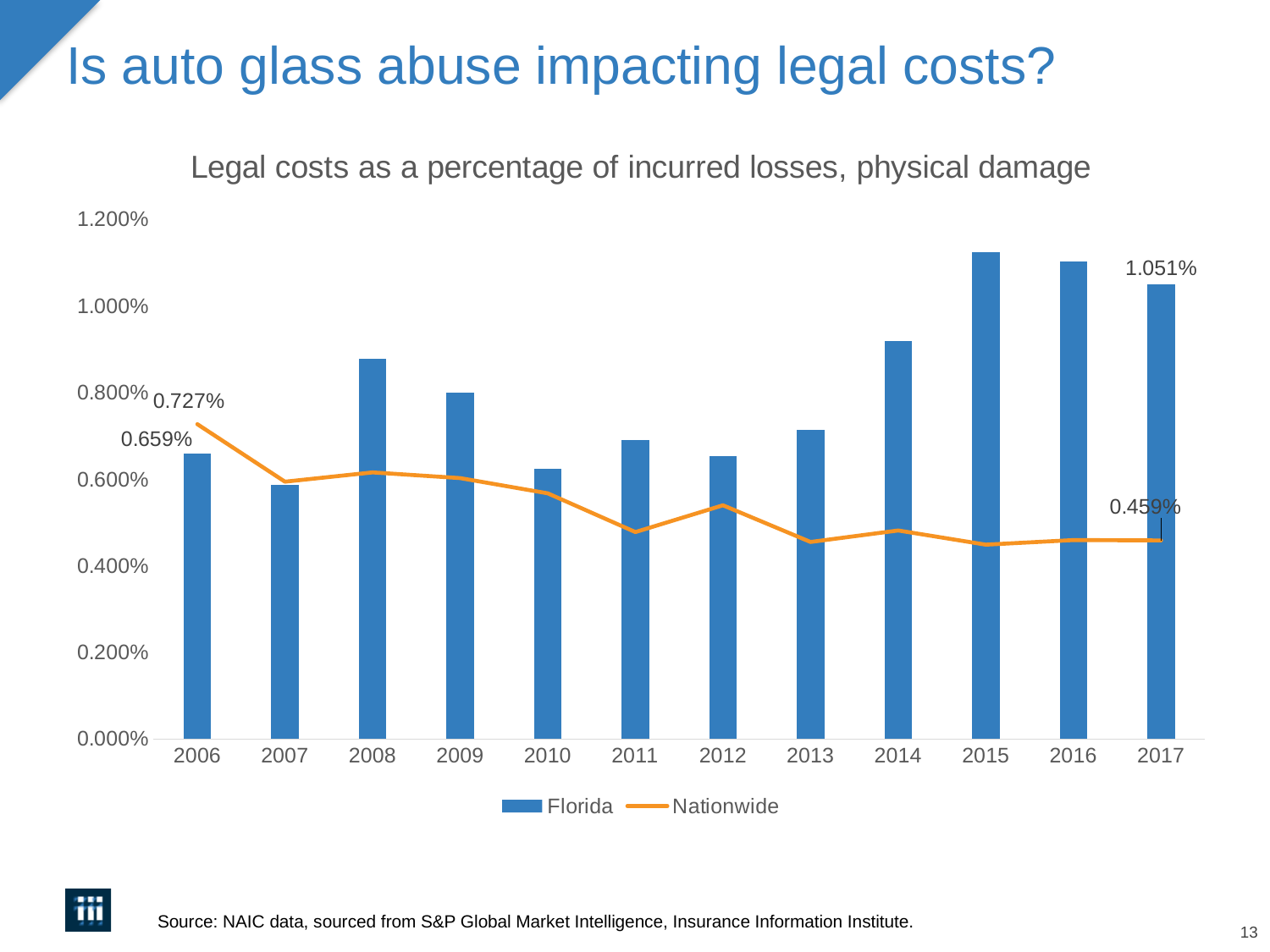
By how much did the Nationwide value decrease from 2006 to 2017? 0.268% What is the Florida value for 2006? 0.659% How many years are shown on the x axis? 12 What is the Nationwide value for 2006? 0.727% Is the Florida value for 2014 greater or less than 1.000%? less In 2006, which is larger: the Florida value or the Nationwide value? Nationwide By how much did the Florida value increase from 2006 to 2017? 0.392% What is the Florida value for 2017? 1.051% Is the Nationwide value for 2011 greater or less than 0.600%? less What is the Nationwide value for 2017? 0.459% How many series does the legend list? 2 In which year is the Florida value lowest? 2007